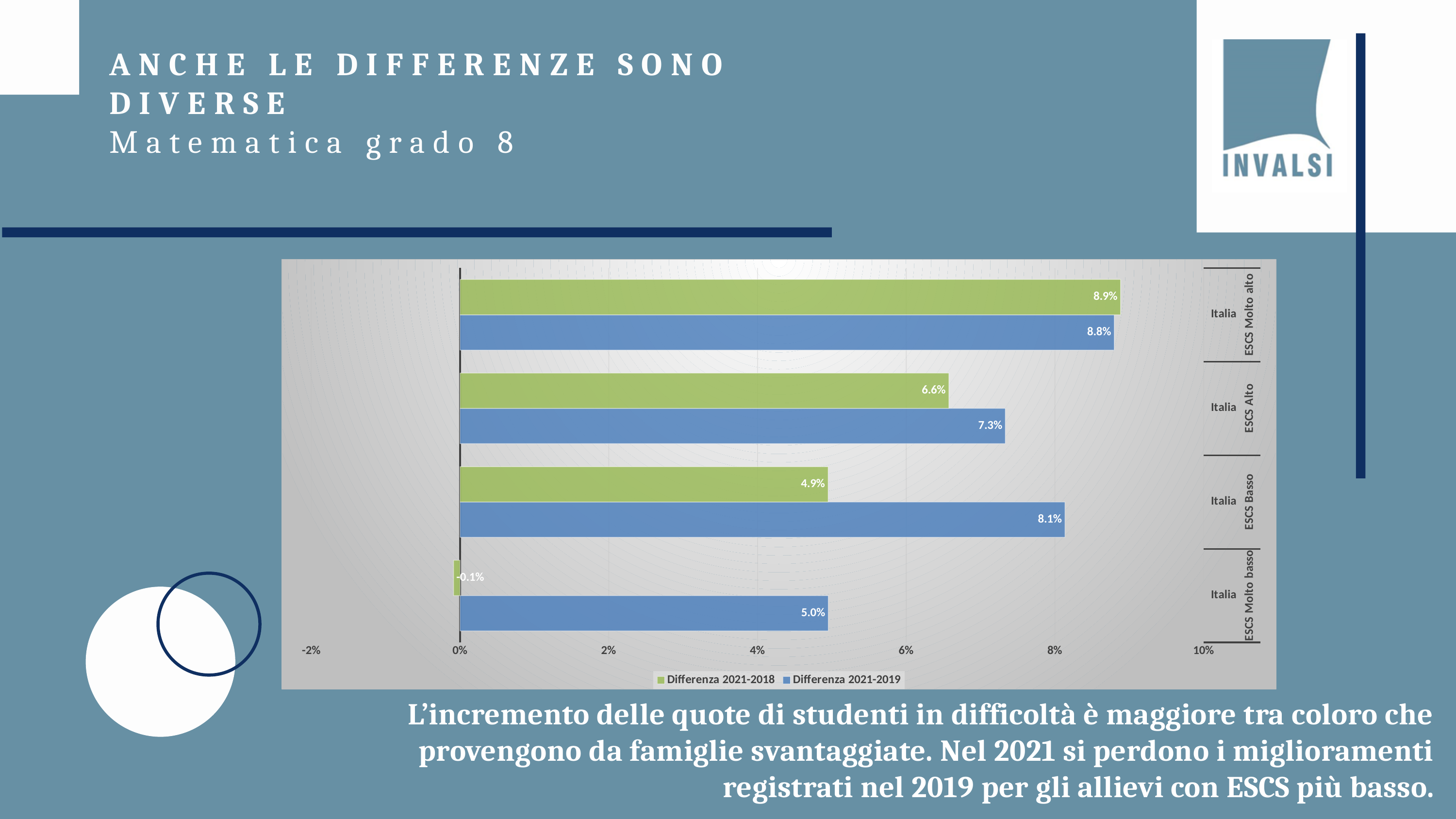
How many series does the legend list? 2 What is the value of Differenza 2021-2019 for Italia ESCS Basso? 8.1% Which category has the lowest value for Differenza 2021-2018? Italia ESCS Molto basso What is the value of Differenza 2021-2018 for Italia ESCS Molto basso? -0.1% What is the value of Differenza 2021-2018 for Italia ESCS Molto alto? 8.9% How many categories are shown on the chart? 4 Which colour represents the series Differenza 2021-2019? Blue What kind of chart is shown on the slide? Bar chart What is the difference between Differenza 2021-2019 and Differenza 2021-2018 for Italia ESCS Basso? 3.2% What is the value of Differenza 2021-2019 for Italia ESCS Alto? 7.3% For Italia ESCS Alto, which series has the larger value: Differenza 2021-2018 or Differenza 2021-2019? Differenza 2021-2019 Which category has the highest value for Differenza 2021-2019? Italia ESCS Molto alto